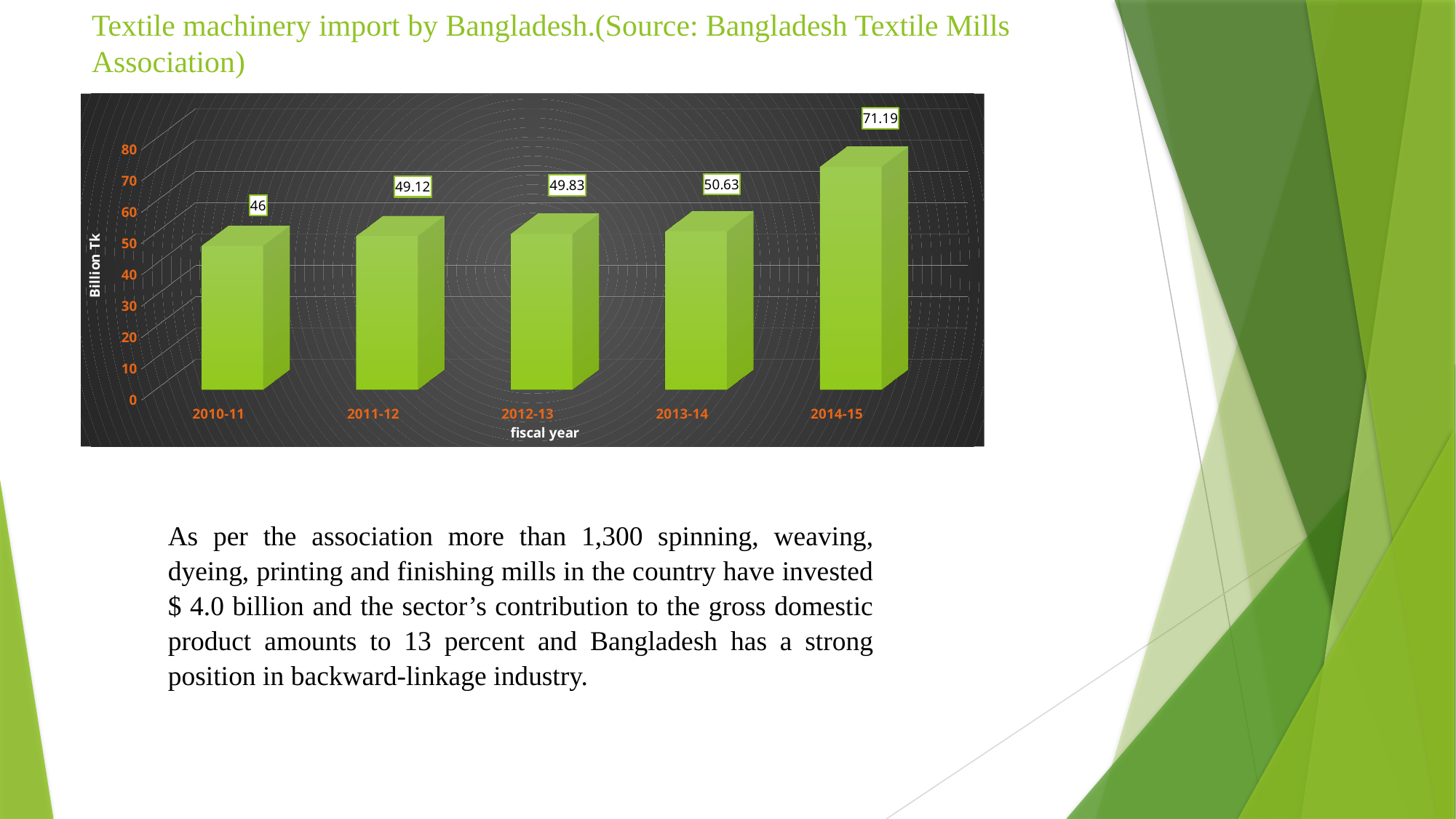
What is the value for fiscal year 2014-15? 71.19 What is the value for fiscal year 2010-11? 46 Is the value for 2014-15 greater or less than 60? greater Which fiscal year has the highest value? 2014-15 What is the difference between the values for 2014-15 and 2013-14? 20.56 What is the difference between the values for 2011-12 and 2010-11? 3.12 What is the value for fiscal year 2012-13? 49.83 How many fiscal years are shown on the x axis? 5 What kind of chart is shown on the slide? bar chart What is the label of the vertical axis? Billion Tk Which fiscal year has the lowest value? 2010-11 Which is larger, the value for 2013-14 or the value for 2010-11? 2013-14